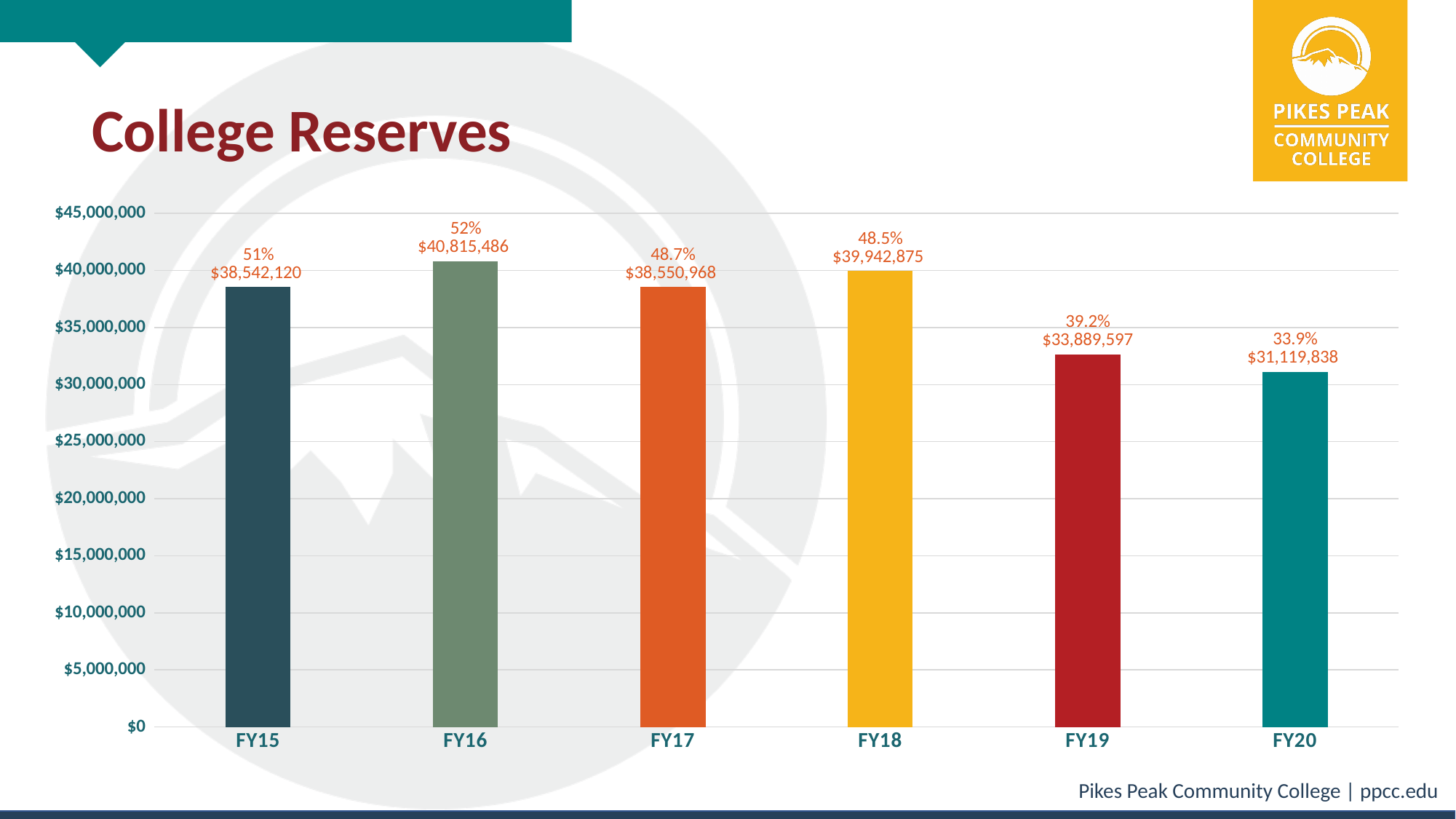
Which has larger college reserves, FY18 or FY19? FY18 Is the value for FY19 greater or less than $35,000,000? less From FY18 to FY20, do the college reserves rise or fall? fall Which fiscal year has the lowest college reserves? FY20 What is the value of college reserves for FY16? $40,815,486 What is the difference in college reserves between FY18 and FY19? $6,053,278 What is the value of college reserves for FY20? $31,119,838 What is the difference in college reserves between FY16 and FY20? $9,695,648 Which fiscal year has the highest college reserves? FY16 How many fiscal years are shown in the chart? 6 What kind of chart is shown on the slide? bar chart What percentage is shown above the FY19 bar? 39.2%